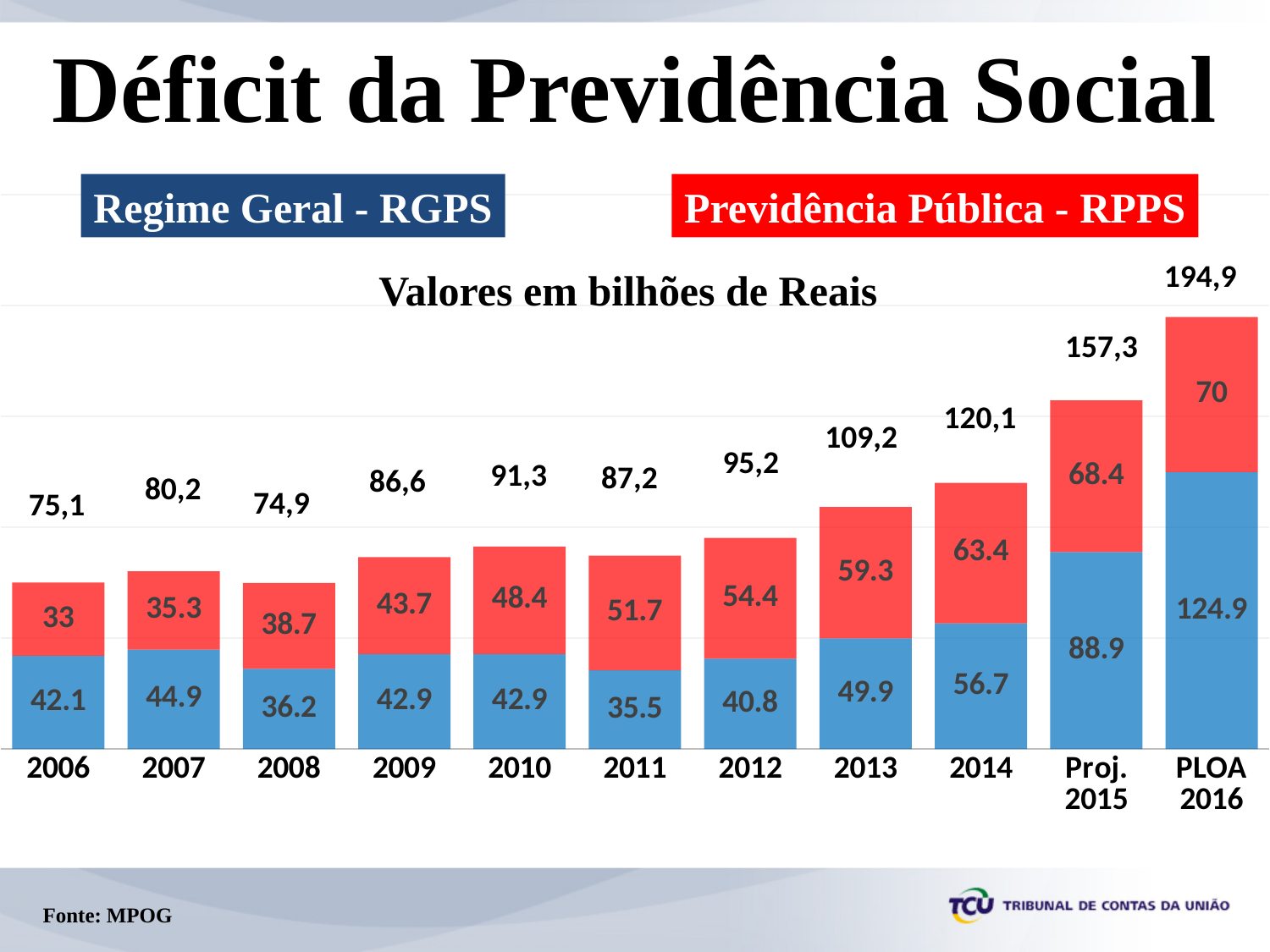
What is the RGPS (blue) value for 2014? 56.7 How many series does the chart show? 2 What is the RPPS (red) value for 2010? 48.4 Which is larger, the RGPS (blue) value for 2007 or for 2008? 2007 Do the RPPS (red) values rise or fall from 2006 to PLOA 2016? rise Which year has the lowest RGPS (blue) value? 2011 Which category has the highest total deficit? PLOA 2016 What is the difference between the RPPS (red) values for PLOA 2016 and 2006? 37 What is the total deficit shown above the bar for 2013? 109,2 What type of chart is shown on the slide? stacked bar chart Which colour represents Regime Geral - RGPS? blue How many categories are shown on the x axis? 11